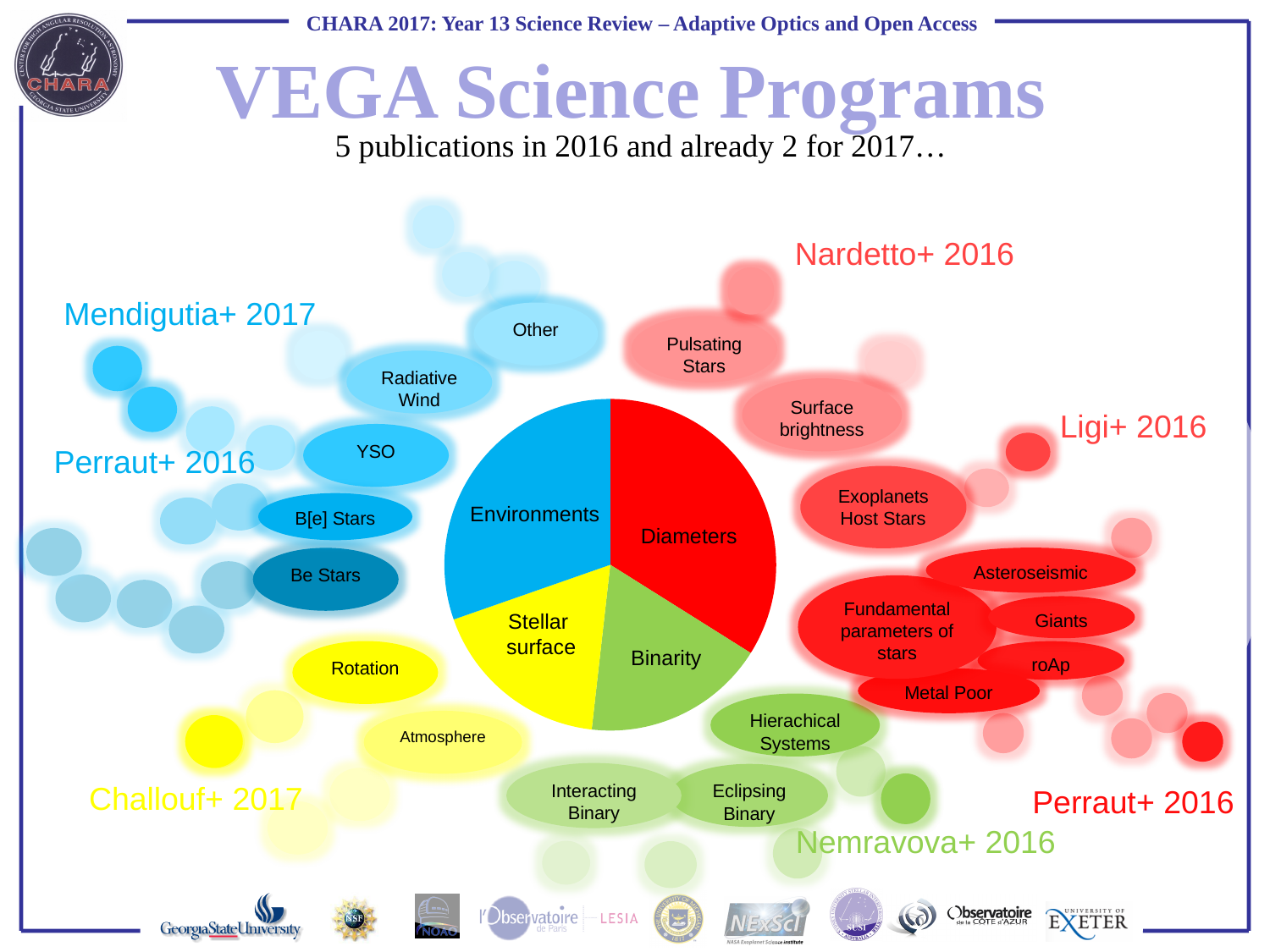
What colour is the Environments slice of the pie chart? blue Which slice of the pie chart is larger, Diameters or Stellar surface? Diameters How many slices does the pie chart have? 4 Which slice of the pie chart is larger, Environments or Binarity? Environments What colour is the Diameters slice of the pie chart? red What kind of chart is shown in the centre of the slide? pie chart Which slice of the pie chart is larger, Diameters or Binarity? Diameters